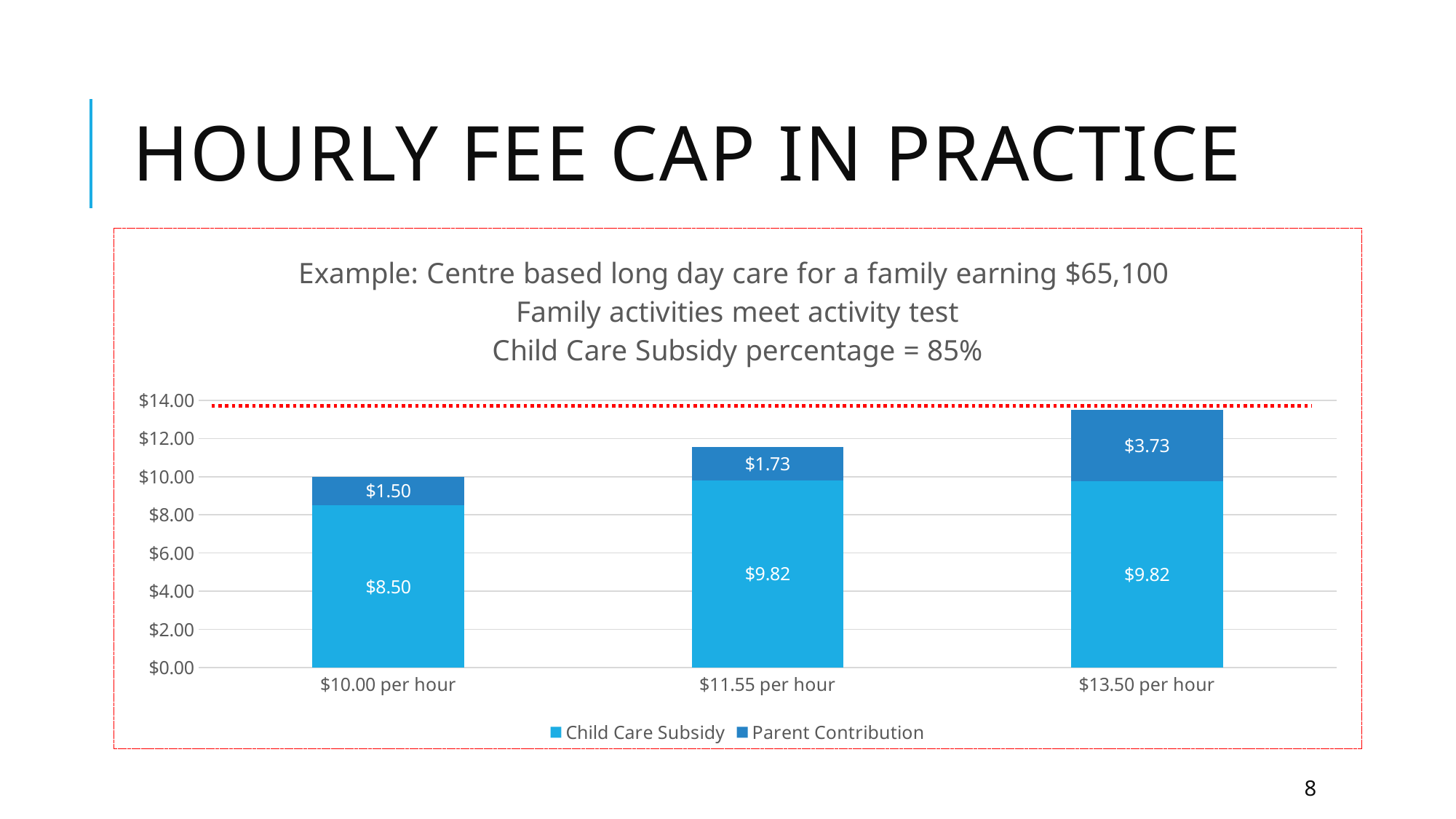
How many categories are shown on the x axis? 3 What is the total of the stacked bar for the $10.00 per hour category? $10.00 Which category has the highest Parent Contribution? $13.50 per hour What is the Parent Contribution value for the $11.55 per hour category? $1.73 What type of chart is shown on the slide? Stacked bar chart Which category has the lowest Child Care Subsidy? $10.00 per hour What is the difference between the Parent Contribution for $13.50 per hour and for $11.55 per hour? $2.00 What is the Parent Contribution value for the $13.50 per hour category? $3.73 What is the total of the stacked bar for the $11.55 per hour category? $11.55 How many series does the legend list? 2 Is the Child Care Subsidy larger for $10.00 per hour or for $11.55 per hour? $11.55 per hour What is the Child Care Subsidy value for the $10.00 per hour category? $8.50